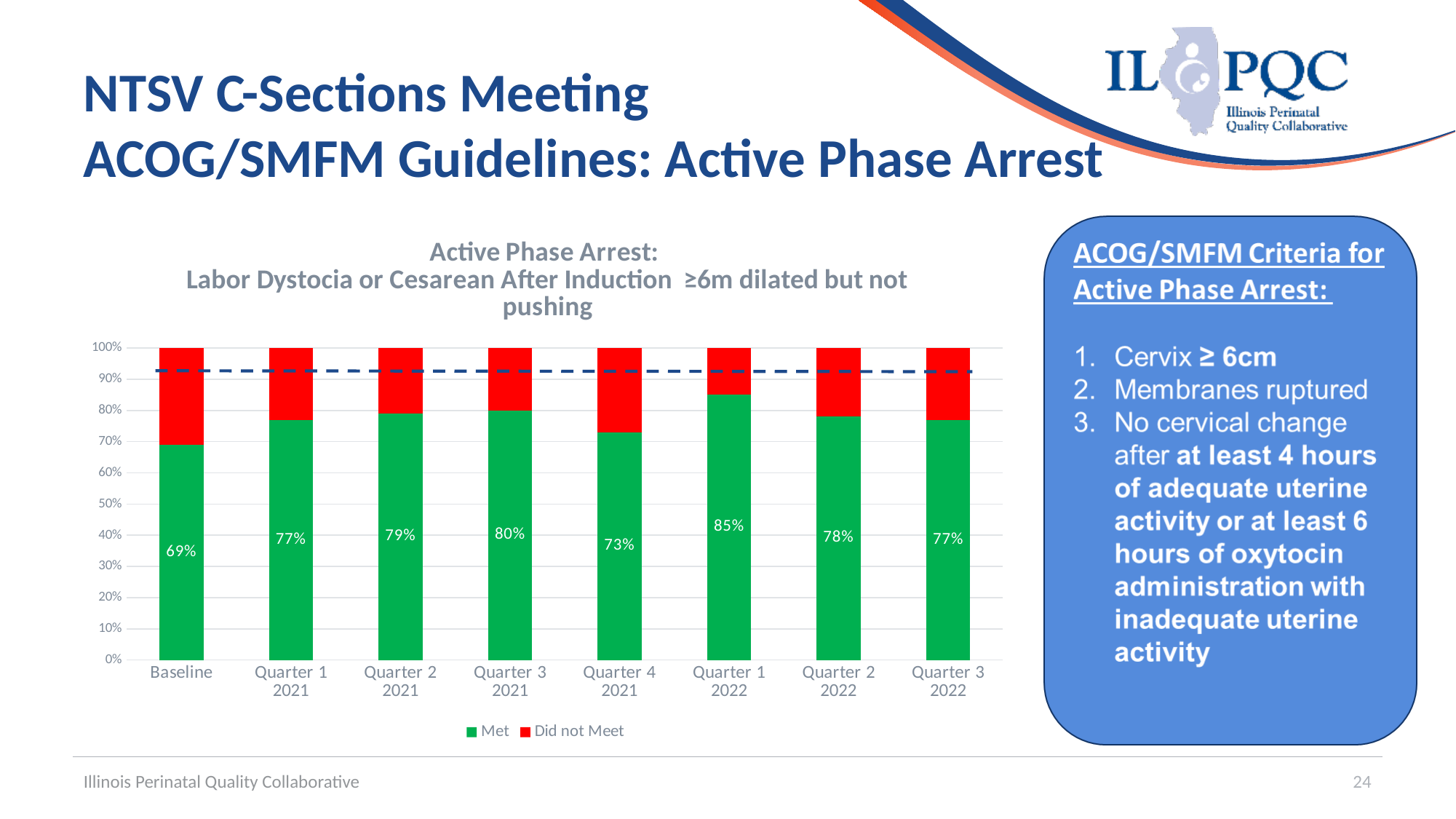
What is the Met value for Quarter 4 2021? 73% Does the Met value rise or fall from Baseline to Quarter 3 2021? Rise What is the Met value for Baseline? 69% What is the difference between the Met value for Quarter 1 2022 and the Met value for Baseline? 16 percentage points How many categories are shown on the x axis? 8 Which category has the lowest Met value? Baseline What is the Met value for Quarter 1 2022? 85% What kind of chart is shown on the slide? Stacked bar chart Which has a larger Met value, Quarter 2 2021 or Quarter 4 2021? Quarter 2 2021 How many series does the legend list? 2 Is the Did not Meet value for Baseline greater or less than 20%? greater Which category has the highest Met value? Quarter 1 2022